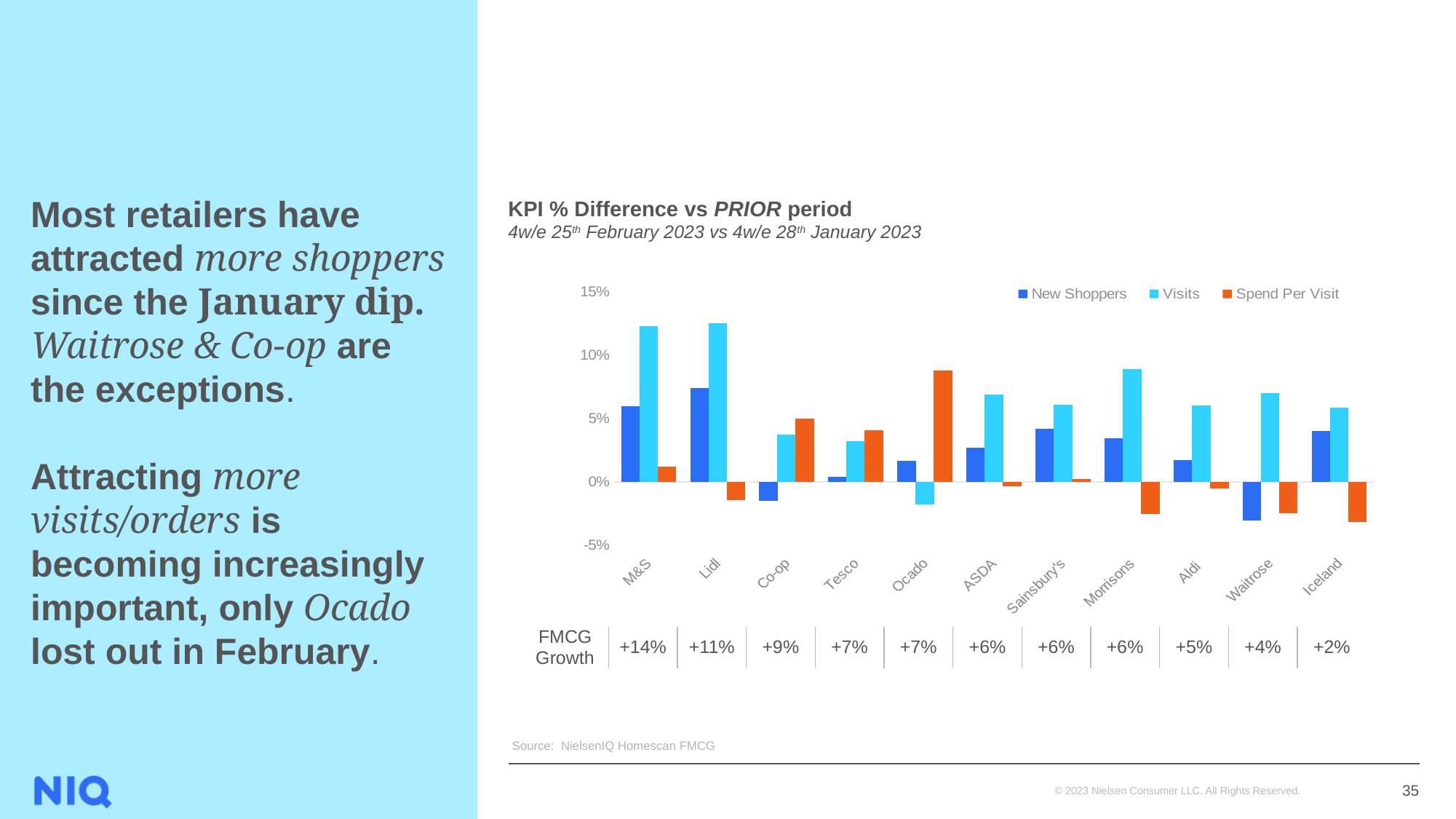
What is the FMCG Growth value shown for M&S? +14% Is the Visits value for M&S greater or less than 10%? greater Is the Spend Per Visit value for Iceland greater or less than 0%? less What is the difference in percentage points between the FMCG Growth of M&S (+14%) and Iceland (+2%)? 12 percentage points How many series does the chart legend list? 3 What is the FMCG Growth value shown for Waitrose? +4% Which retailer has the lowest FMCG Growth value in the row beneath the chart? Iceland Do the FMCG Growth values rise or fall moving from M&S on the left to Iceland on the right? fall Which retailer has the highest Spend Per Visit bar? Ocado What kind of chart is shown on the slide? Bar chart How many retailers are shown on the x axis of the chart? 11 Which retailer has the lowest New Shoppers bar? Waitrose